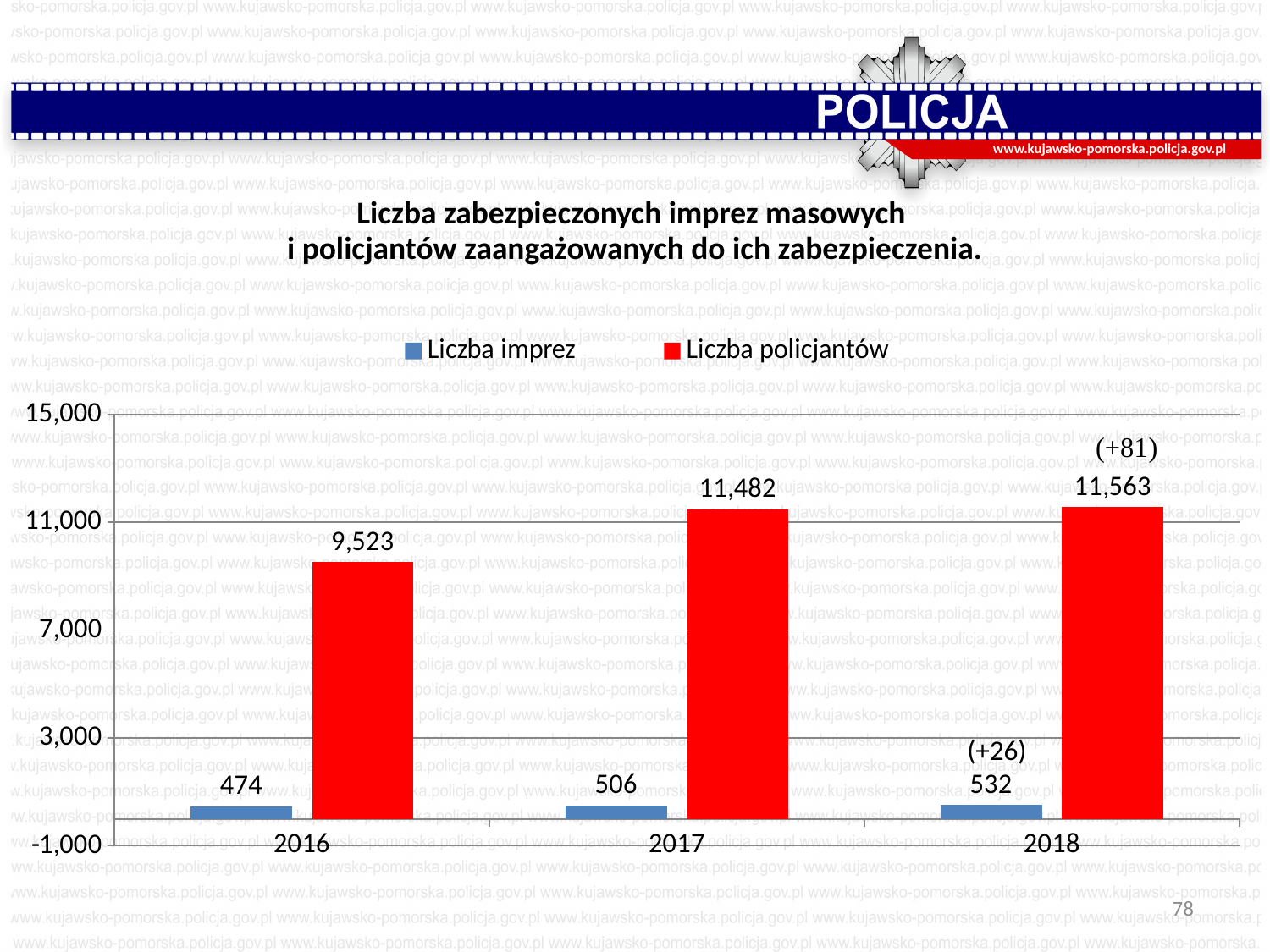
Does Liczba policjantów rise or fall from 2016 to 2018? rise Is the value of Liczba policjantów for 2016 greater or less than 11,000? less What is the value of Liczba imprez for 2018? 532 Which is larger: Liczba imprez in 2017 or Liczba imprez in 2018? 2018 What is the value of Liczba imprez for 2016? 474 How many years are shown on the x axis? 3 Which year has the highest value for Liczba policjantów? 2018 What is the difference between Liczba policjantów in 2017 and 2016? 1,959 How many series does the legend list? 2 What is the value of Liczba policjantów for 2017? 11,482 What is the value of Liczba policjantów for 2016? 9,523 Which year has the lowest value for Liczba imprez? 2016